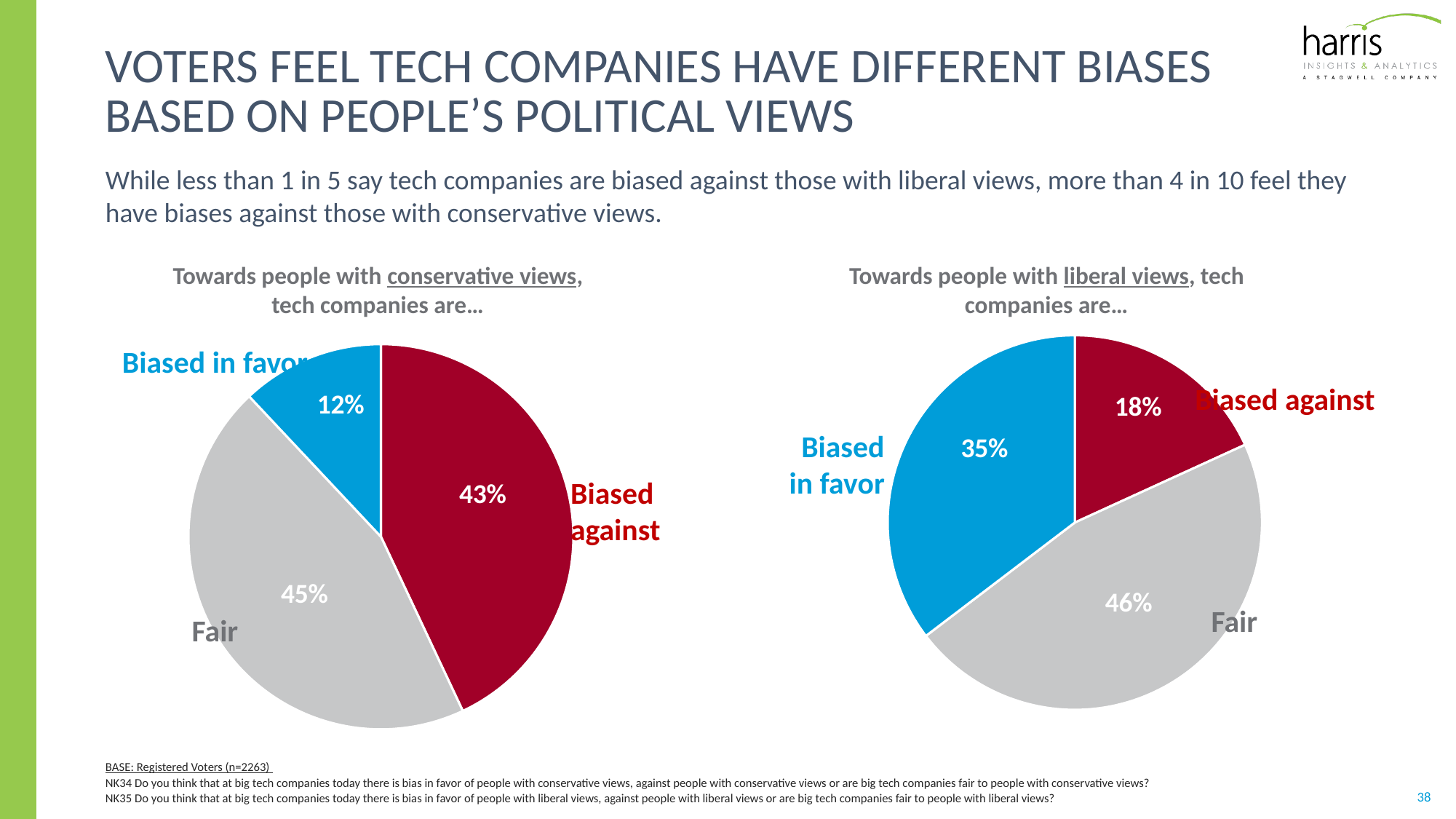
In the left pie chart (towards people with conservative views), what percentage say tech companies are biased against? 43% In the left pie chart (towards people with conservative views), which response has the smallest share? Biased in favor In the right pie chart (towards people with liberal views), what percentage say tech companies are fair? 46% What is the difference between the Biased against share in the left pie chart (conservative views) and the Biased against share in the right pie chart (liberal views)? 25 percentage points What type of chart is used on this slide? Pie chart In the left pie chart (towards people with conservative views), what is the difference between the Fair share and the Biased in favor share? 33 percentage points In the left pie chart (towards people with conservative views), what percentage say tech companies are biased in favor? 12% In the right pie chart (towards people with liberal views), which is larger: Biased in favor or Biased against? Biased in favor How many slices does the right pie chart (towards people with liberal views) have? 3 What colour is the Fair slice in both pie charts? Grey In the right pie chart (towards people with liberal views), which response has the largest share? Fair In the right pie chart (towards people with liberal views), what percentage say tech companies are biased in favor? 35%